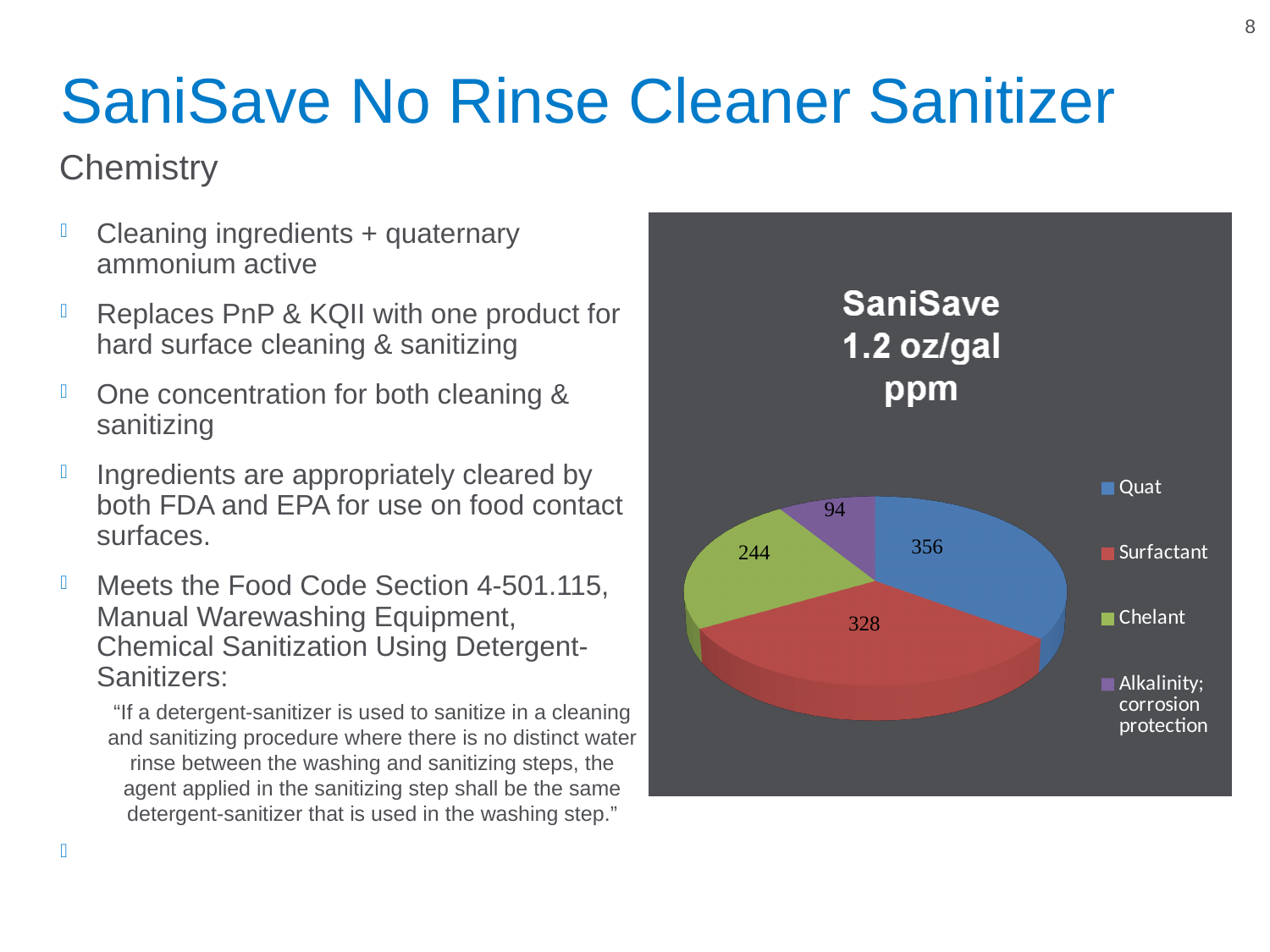
Which category has the smallest slice in the pie chart? Alkalinity; corrosion protection How much larger is the Chelant value than the Alkalinity; corrosion protection value? 150 Which is larger, the Surfactant value or the Chelant value? Surfactant What is the value for the Alkalinity; corrosion protection slice? 94 What is the value for Chelant in the pie chart? 244 Which category has the largest slice in the pie chart? Quat How many categories does the pie chart show? 4 What is the value for Quat in the pie chart? 356 What is the difference between the Quat value and the Surfactant value? 28 What kind of chart is shown on the slide? Pie chart What is the value for Surfactant in the pie chart? 328 What is the title of the chart? SaniSave 1.2 oz/gal ppm